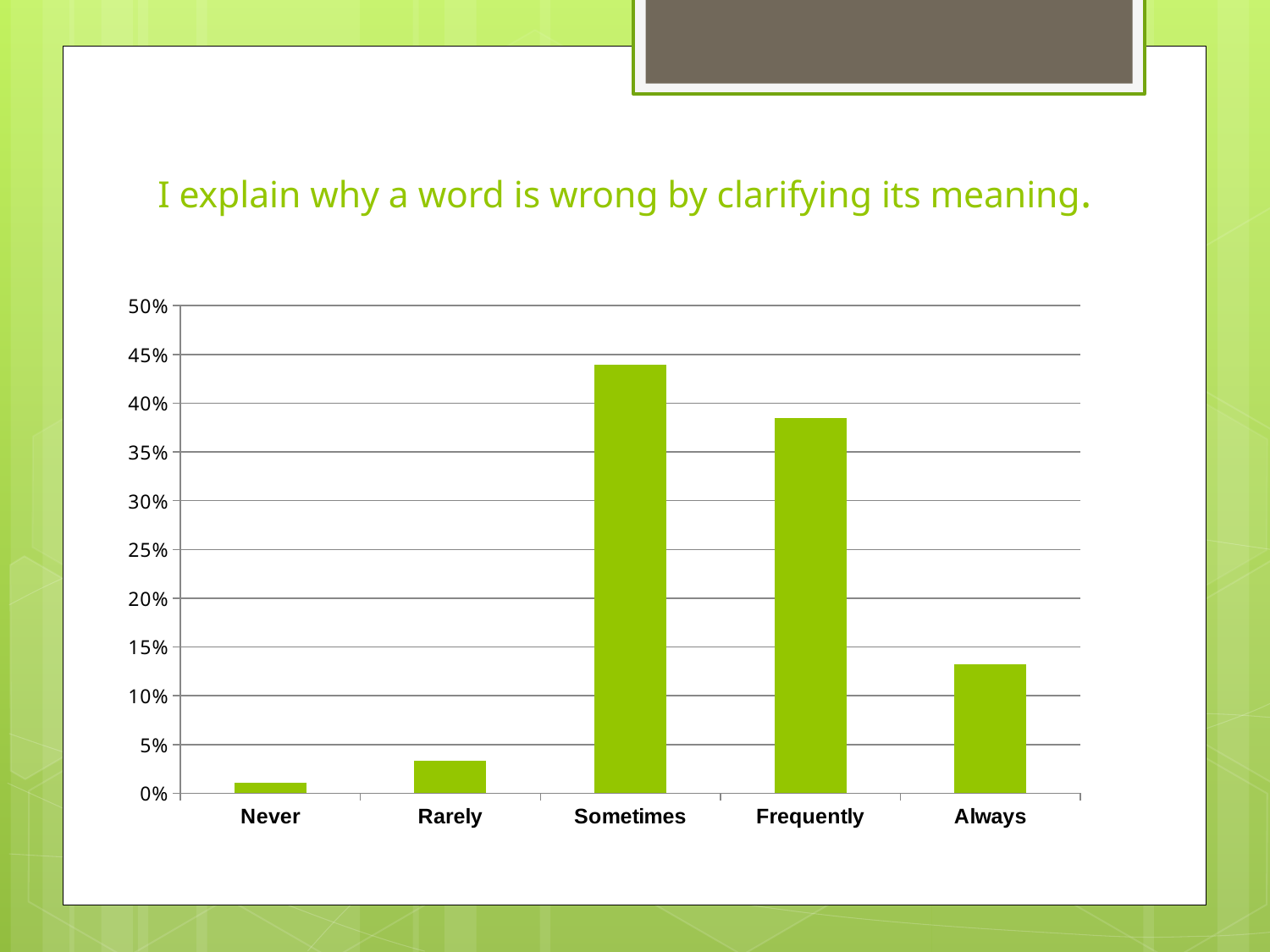
What is the highest value shown on the y axis? 50% What is the title of the chart? I explain why a word is wrong by clarifying its meaning. Which category has the lowest value? Never Which category has the highest value? Sometimes Is the value for Rarely greater or less than 5%? less Is the value for Always greater or less than 10%? greater Is the value for Frequently greater or less than 40%? less What kind of chart is shown on the slide? bar chart Which is larger, the value for Frequently or the value for Always? Frequently Which is larger, the value for Never or the value for Rarely? Rarely How many categories are shown on the x axis? 5